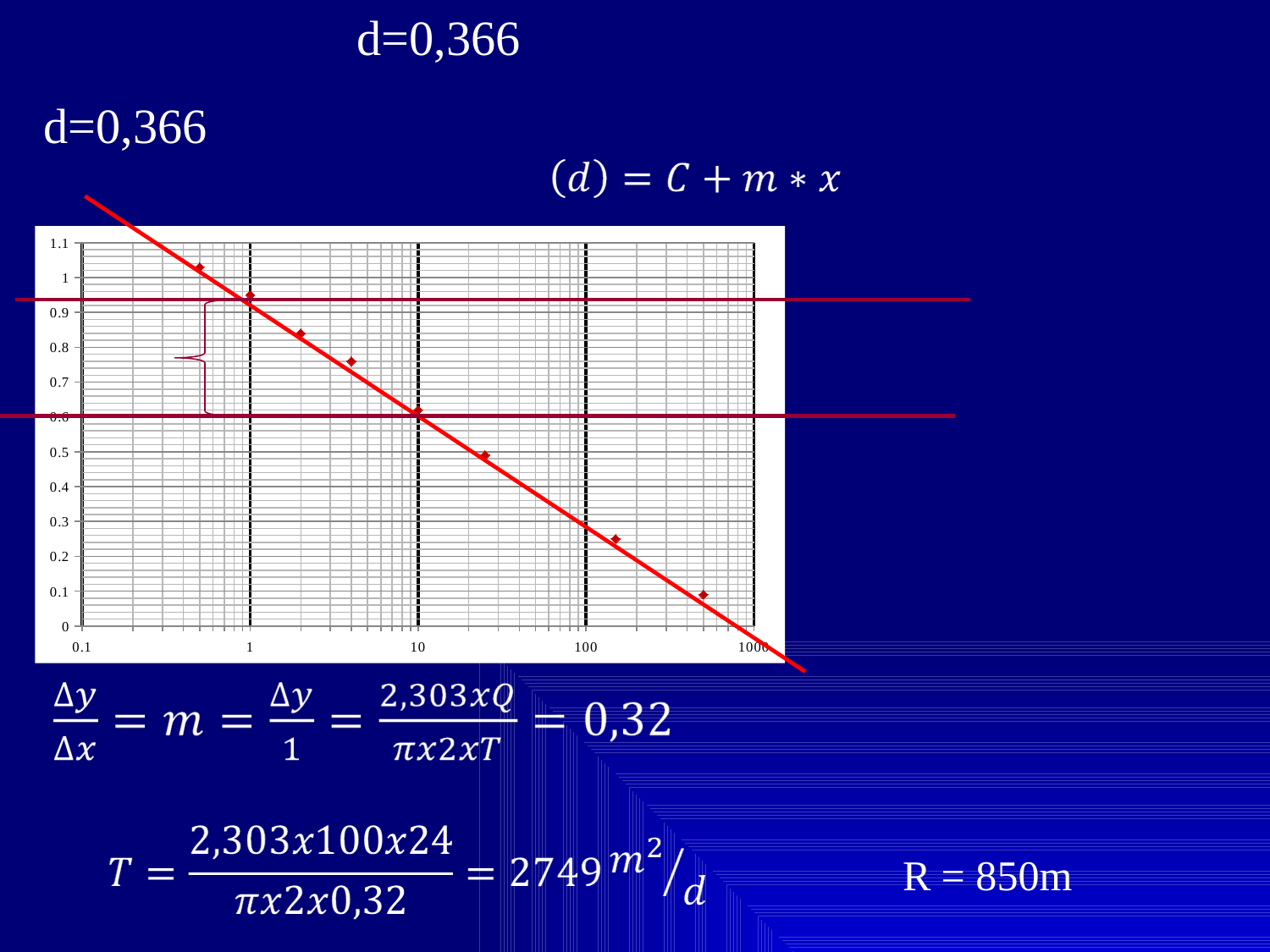
Which data point has the highest value on the chart? the leftmost point What is the largest tick value shown on the y axis? 1.1 Which has the larger value, the leftmost data point or the rightmost data point? the leftmost data point How many data points are plotted on the chart? 8 Is the value of the data point plotted between x = 100 and x = 1000 greater or less than 0.3? less Do the plotted values rise or fall as x increases along the x axis? fall Is the value of the leftmost data point greater or less than 0.9? greater Which data point has the lowest value on the chart? the rightmost point What kind of chart is shown on the slide? scatter chart What is the largest tick value shown on the x axis? 1000 Is the value of the rightmost data point greater or less than 0.2? less